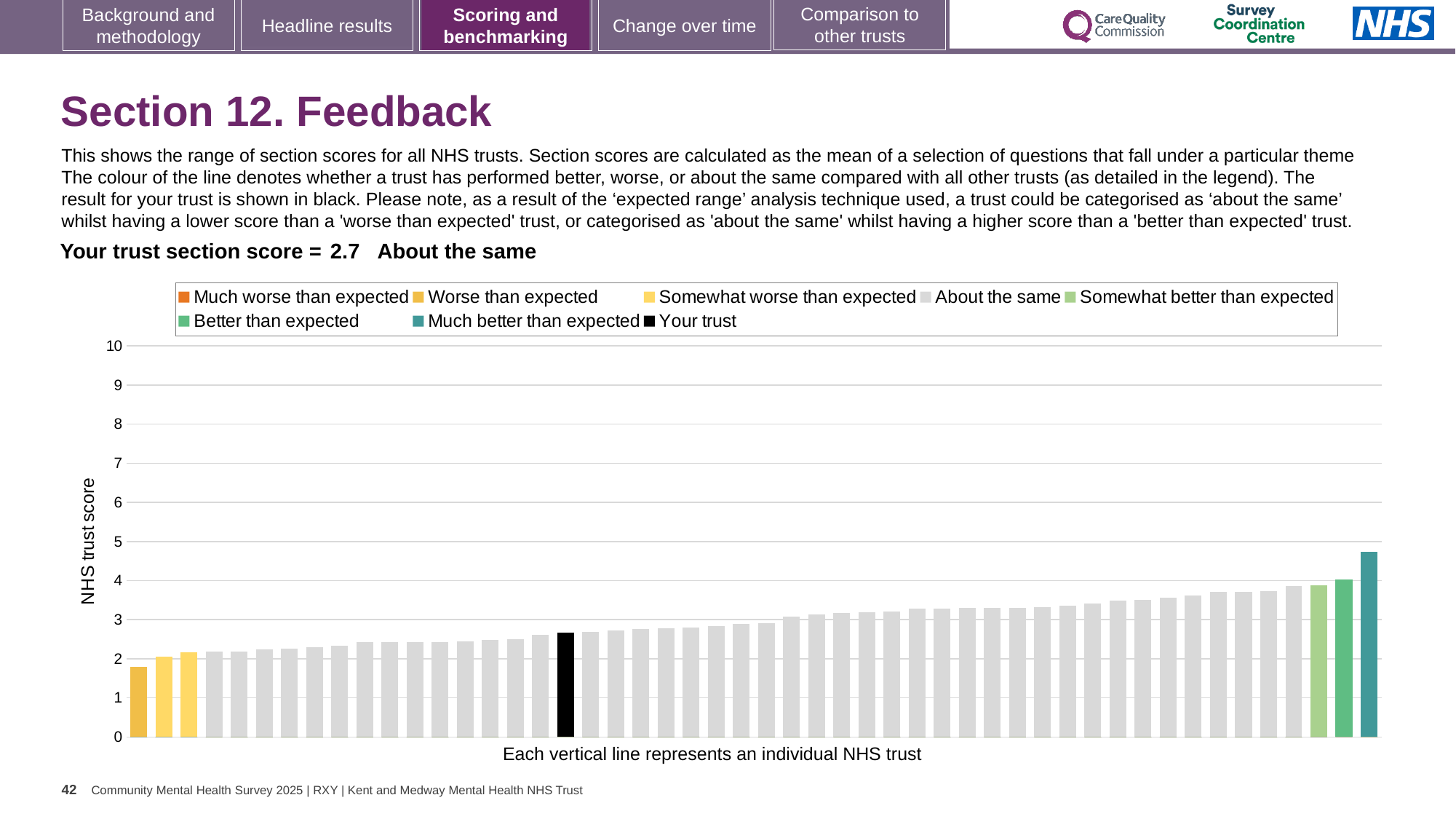
Is the value of the leftmost (lowest) bar greater or less than 2? less Which legend category does the shortest bar belong to? Worse than expected Do the bar values rise or fall from left to right along the x axis? Rise What kind of chart is shown on the slide? Bar chart Is the value of the tallest bar greater or less than 4? greater What is the label on the vertical axis of the chart? NHS trust score What is the section score for your trust shown on the slide? 2.7 Which legend category does the tallest bar belong to? Much better than expected Which category is your trust's section score placed in? About the same Is the 'Your trust' bar higher or lower than the leftmost bar? Higher Is the value of the black 'Your trust' bar greater or less than 3? less How many entries does the chart legend list? 8